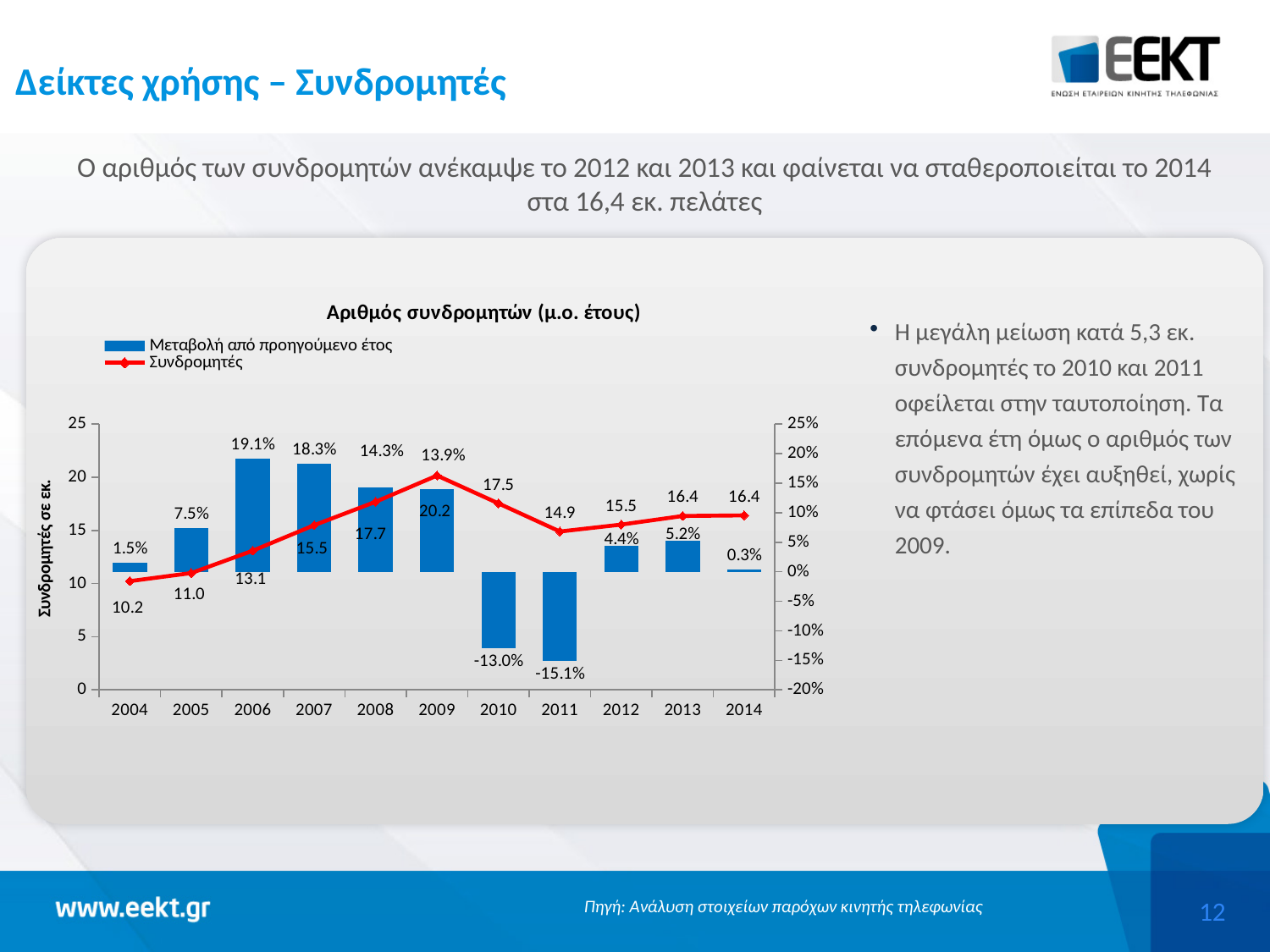
How many years are shown on the x axis? 11 What is the Συνδρομητές value for 2004? 10.2 What is the difference between the Συνδρομητές values for 2009 and 2011? 5.3 Which year has the lowest Συνδρομητές value? 2004 How many series does the legend list? 2 What kind of chart is used for the Μεταβολή από προηγούμενο έτος series? bar chart What is the value of the Συνδρομητές line for 2009? 20.2 Which is larger, the Μεταβολή από προηγούμενο έτος value for 2012 or for 2013? 2013 What is the Μεταβολή από προηγούμενο έτος value for 2011? -15.1% Which year has the highest Μεταβολή από προηγούμενο έτος value? 2006 Does the Συνδρομητές line rise or fall from 2004 to 2009? rise What is the title of the chart? Αριθμός συνδρομητών (μ.ο. έτους)